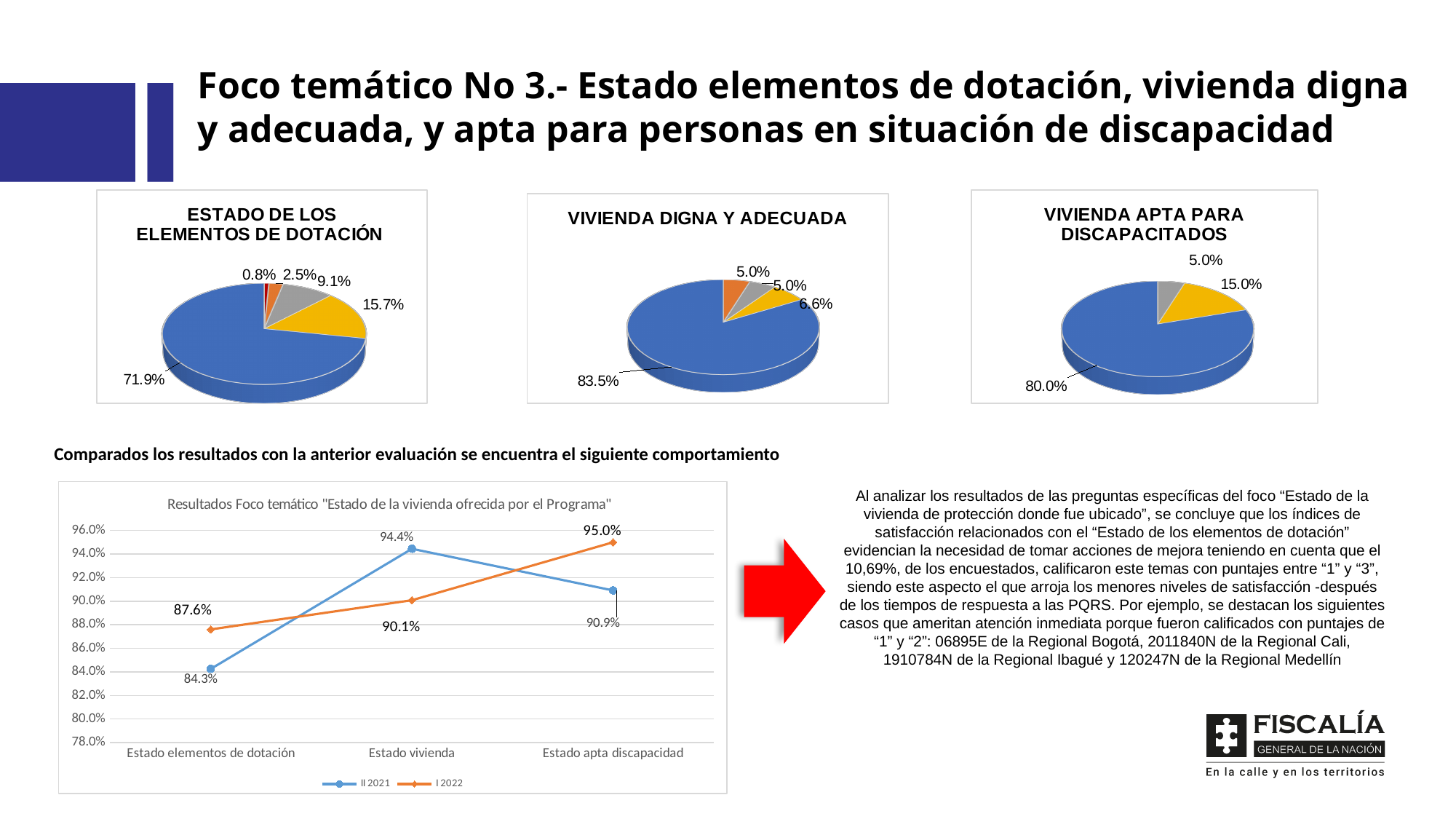
In the pie chart "VIVIENDA APTA PARA DISCAPACITADOS", what is the share of the smallest slice? 5.0% How many categories are shown on the x axis of the line chart "Resultados Foco temático"? 3 In the pie chart "ESTADO DE LOS ELEMENTOS DE DOTACIÓN", what is the share of the largest slice? 71.9% How many series does the legend of the line chart "Resultados Foco temático" list? 2 In the line chart "Resultados Foco temático", what is the value for II 2021 at Estado vivienda? 94.4% What kind of chart is the chart titled "Resultados Foco temático" at the bottom left of the slide? Line chart In the line chart "Resultados Foco temático", what is the value for I 2022 at Estado apta discapacidad? 95.0% In the line chart "Resultados Foco temático", what is the difference between I 2022 and II 2021 at Estado elementos de dotación? 3.3 percentage points In the line chart "Resultados Foco temático", what is the value for II 2021 at Estado apta discapacidad? 90.9% How many slices does the pie chart "ESTADO DE LOS ELEMENTOS DE DOTACIÓN" have? 5 In the line chart "Resultados Foco temático", do the I 2022 values rise or fall from left to right along the x axis? Rise In the line chart "Resultados Foco temático", which series has the higher value at Estado vivienda, II 2021 or I 2022? II 2021